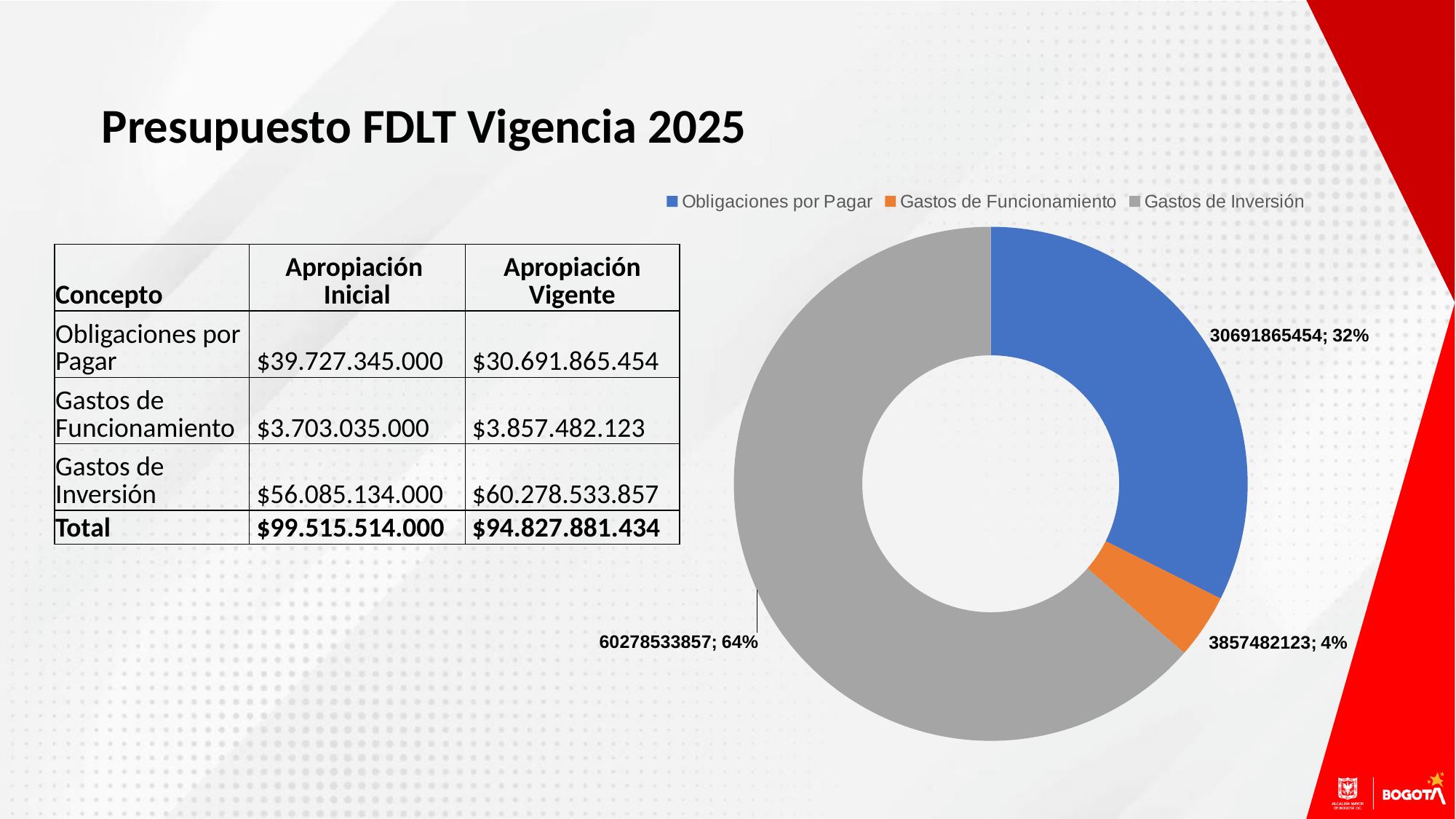
How many entries does the chart legend list? 3 What kind of chart is shown on the slide? Doughnut chart What value is labelled on the Obligaciones por Pagar slice of the chart? 30691865454 What value is labelled on the Gastos de Funcionamiento slice of the chart? 3857482123 Which category has the smallest slice in the doughnut chart? Gastos de Funcionamiento What value is labelled on the Gastos de Inversión slice of the chart? 60278533857 What share of the doughnut chart does Gastos de Funcionamiento represent? 4% What share of the doughnut chart does Gastos de Inversión represent? 64% How many slices does the doughnut chart have? 3 Which category has the largest slice in the doughnut chart? Gastos de Inversión Which colour represents Obligaciones por Pagar in the doughnut chart? Blue What share of the doughnut chart does Obligaciones por Pagar represent? 32%